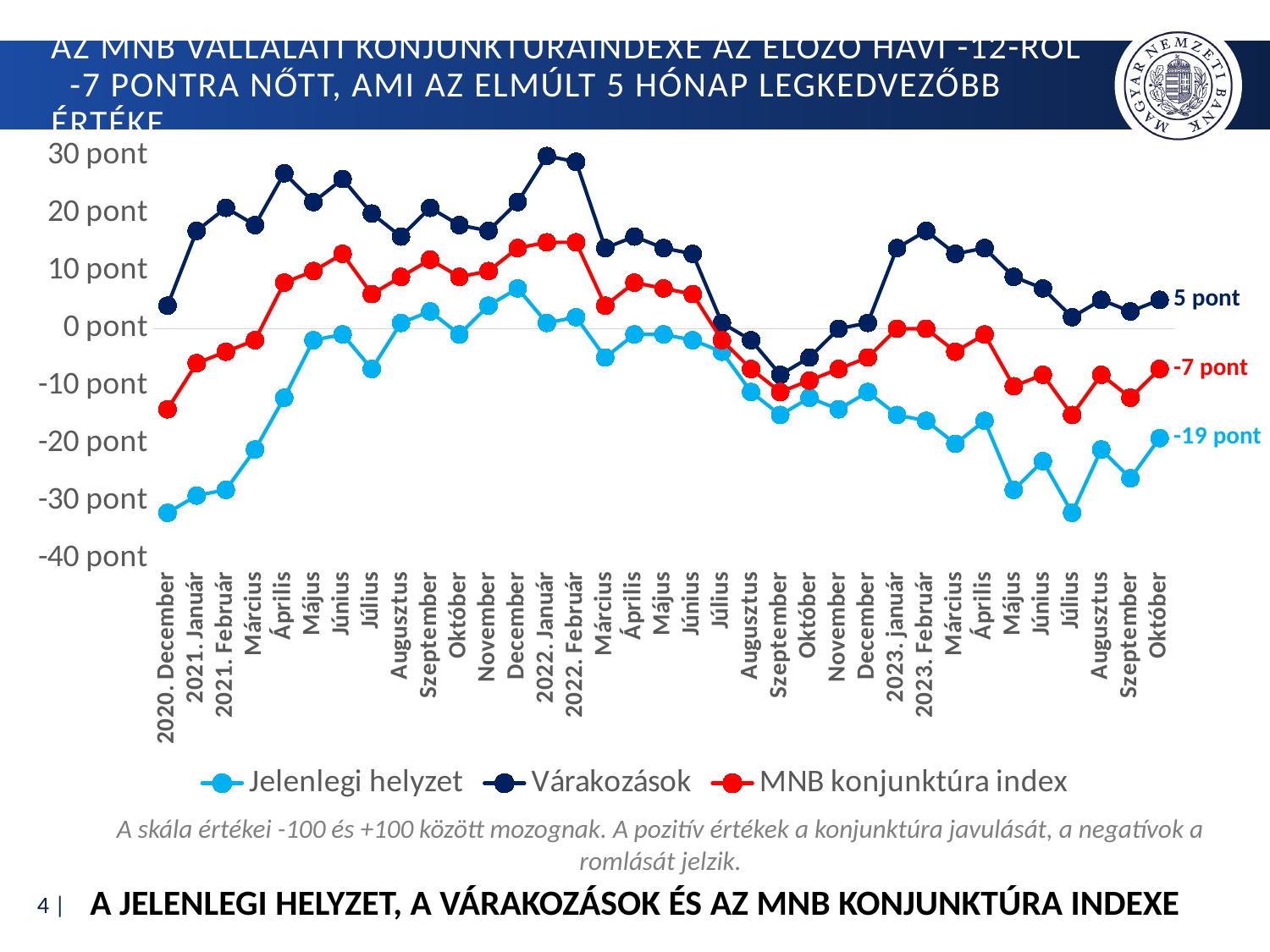
Which series has the lowest value in 2023 Október? Jelenlegi helyzet What kind of chart is shown on the slide? line chart Is the value of Várakozások in 2022 Január greater or less than 20 pont? greater Does the Várakozások series rise or fall between 2022 Február and 2022 Szeptember? fall What is the difference between the Várakozások and the MNB konjunktúra index values in 2023 Október? 12 pont Which series has the highest value in 2023 Október? Várakozások What is the value of the Várakozások series in 2023 Október? 5 pont How many series does the legend list? 3 What is the value of the Jelenlegi helyzet series in 2023 Október? -19 pont Which colour is used for the MNB konjunktúra index series? red What is the value of the MNB konjunktúra index in 2023 Október? -7 pont Is the value of Jelenlegi helyzet in 2020 December greater or less than -30 pont? less